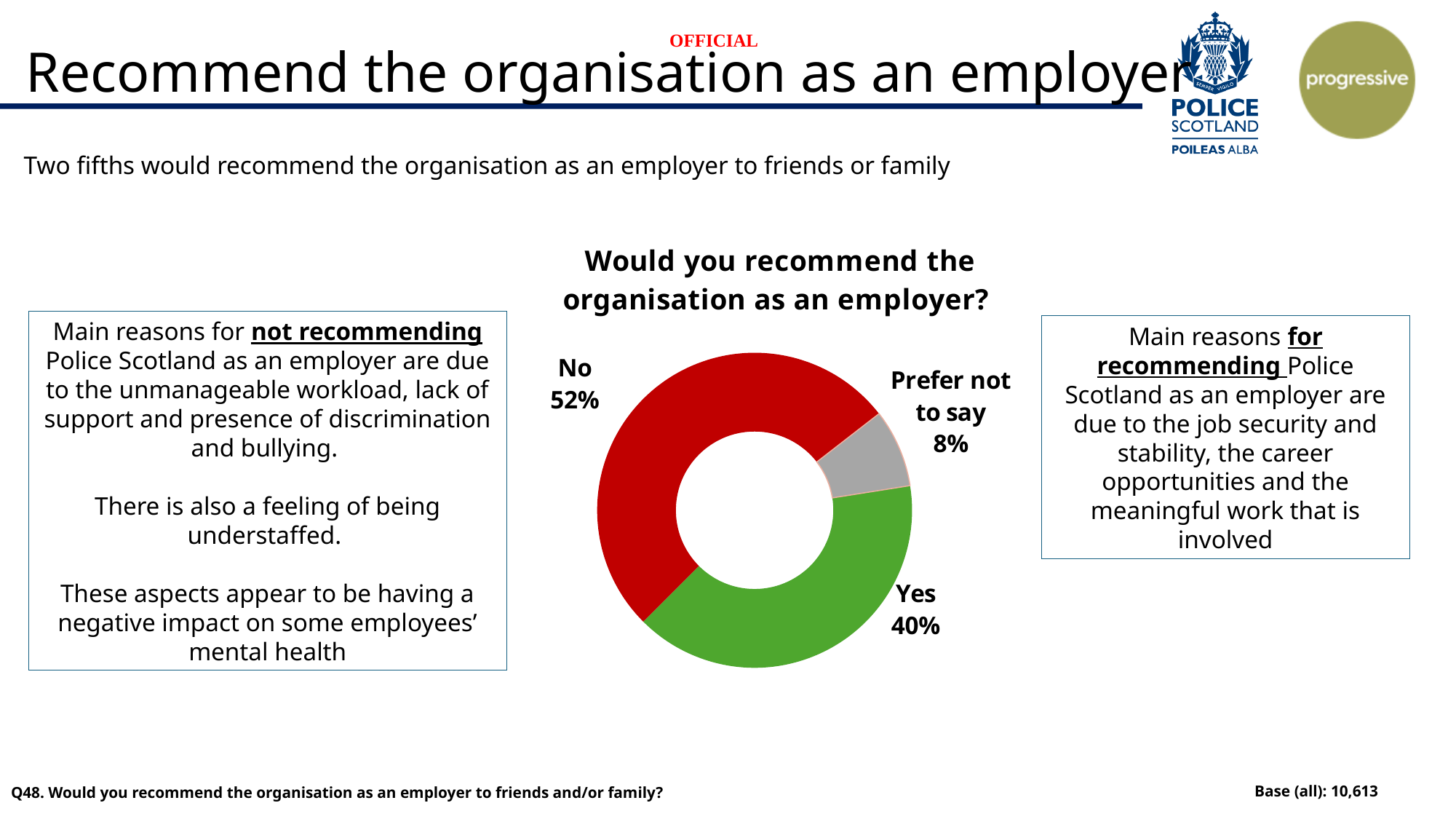
Which response has the largest share of the chart? No What colour is the "Yes" segment of the chart? Green What percentage of respondents chose "Prefer not to say"? 8% How many response categories are shown in the chart? 3 What percentage of respondents answered "No" to whether they would recommend the organisation as an employer? 52% What kind of chart is used to show the responses? Doughnut (pie) chart Which is larger, the share for "Yes" or the share for "Prefer not to say"? Yes Which response has the smallest share of the chart? Prefer not to say What is the difference in percentage points between the "No" and "Yes" responses? 12 What is the title of the chart? Would you recommend the organisation as an employer? What is the combined share of "Yes" and "No" responses? 92% What percentage of respondents answered "Yes" to whether they would recommend the organisation as an employer? 40%